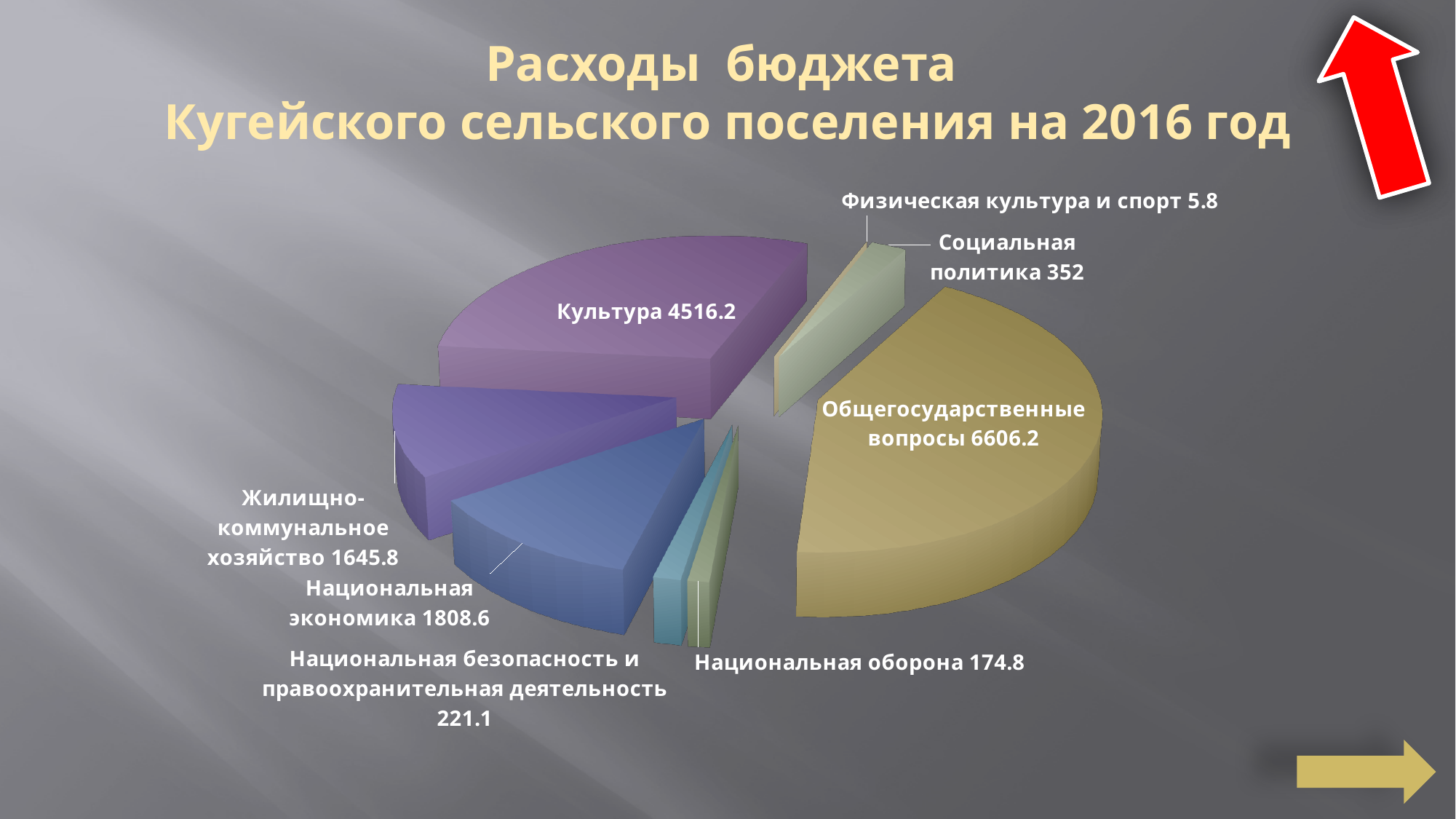
Which is larger: Национальная безопасность и правоохранительная деятельность or Национальная оборона? Национальная безопасность и правоохранительная деятельность What is the value for Общегосударственные вопросы? 6606.2 What kind of chart is shown on the slide? Pie chart Which category has the lowest value? Физическая культура и спорт How many categories does the pie chart show? 8 What is the value for Социальная политика? 352 What is the title of the slide? Расходы бюджета Кугейского сельского поселения на 2016 год What is the difference between Национальная экономика and Жилищно-коммунальное хозяйство? 162.8 What is the difference between Общегосударственные вопросы and Культура? 2090 What is the value for Национальная оборона? 174.8 Which category has the highest value? Общегосударственные вопросы What is the value for Культура? 4516.2